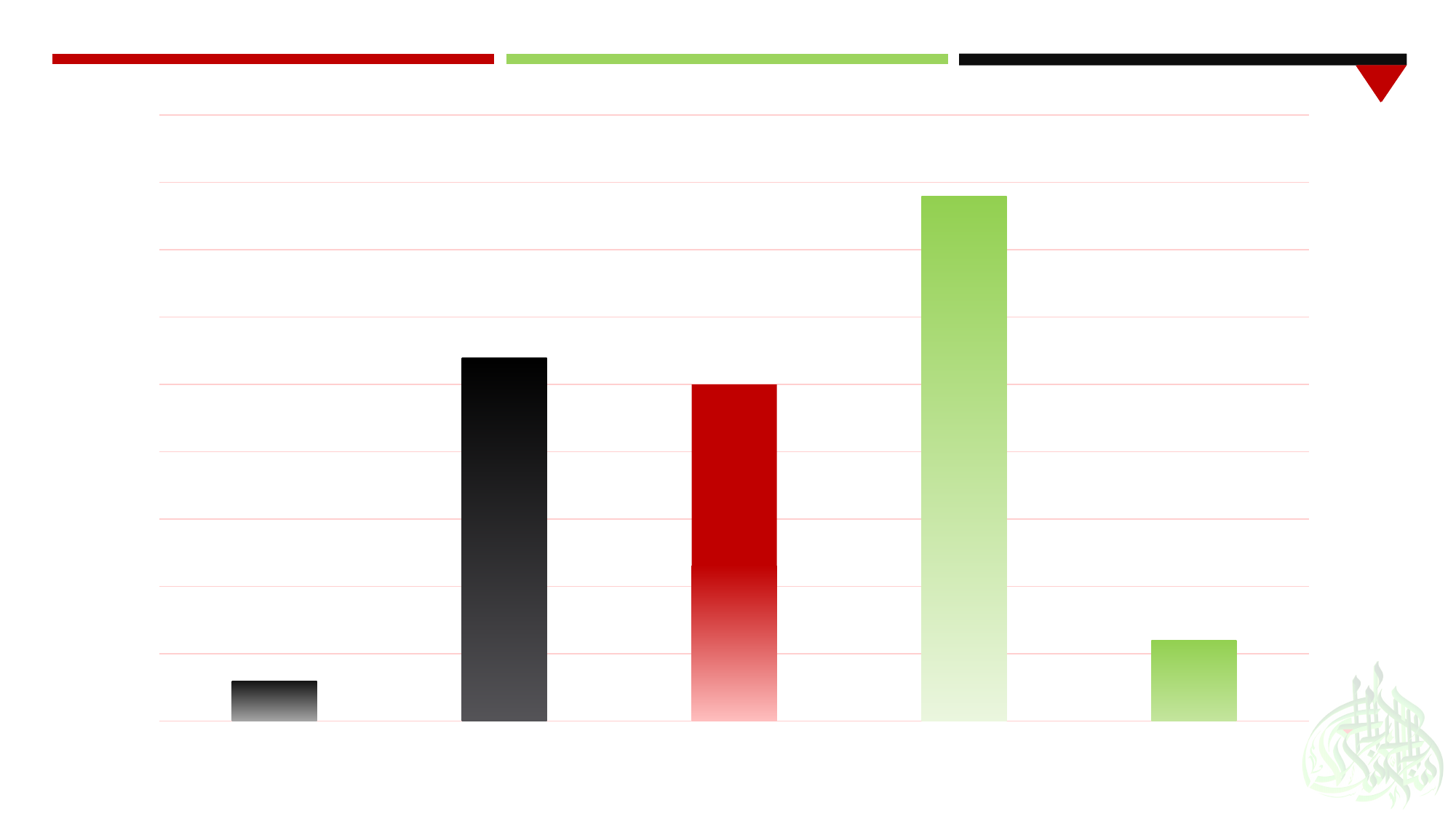
What kind of chart is shown on the slide? bar chart Which bar is the shortest in the chart, counting from the left? the first bar Which is taller, the fourth bar from the left or the second bar from the left? the fourth bar What colour is the tallest bar in the chart? green Which is taller, the second bar from the left or the third bar from the left? the second bar Which is taller, the fifth bar from the left or the first bar from the left? the fifth bar How many bars does the chart contain? 5 Which bar is the tallest in the chart, counting from the left? the fourth bar What colour is the third bar from the left? red